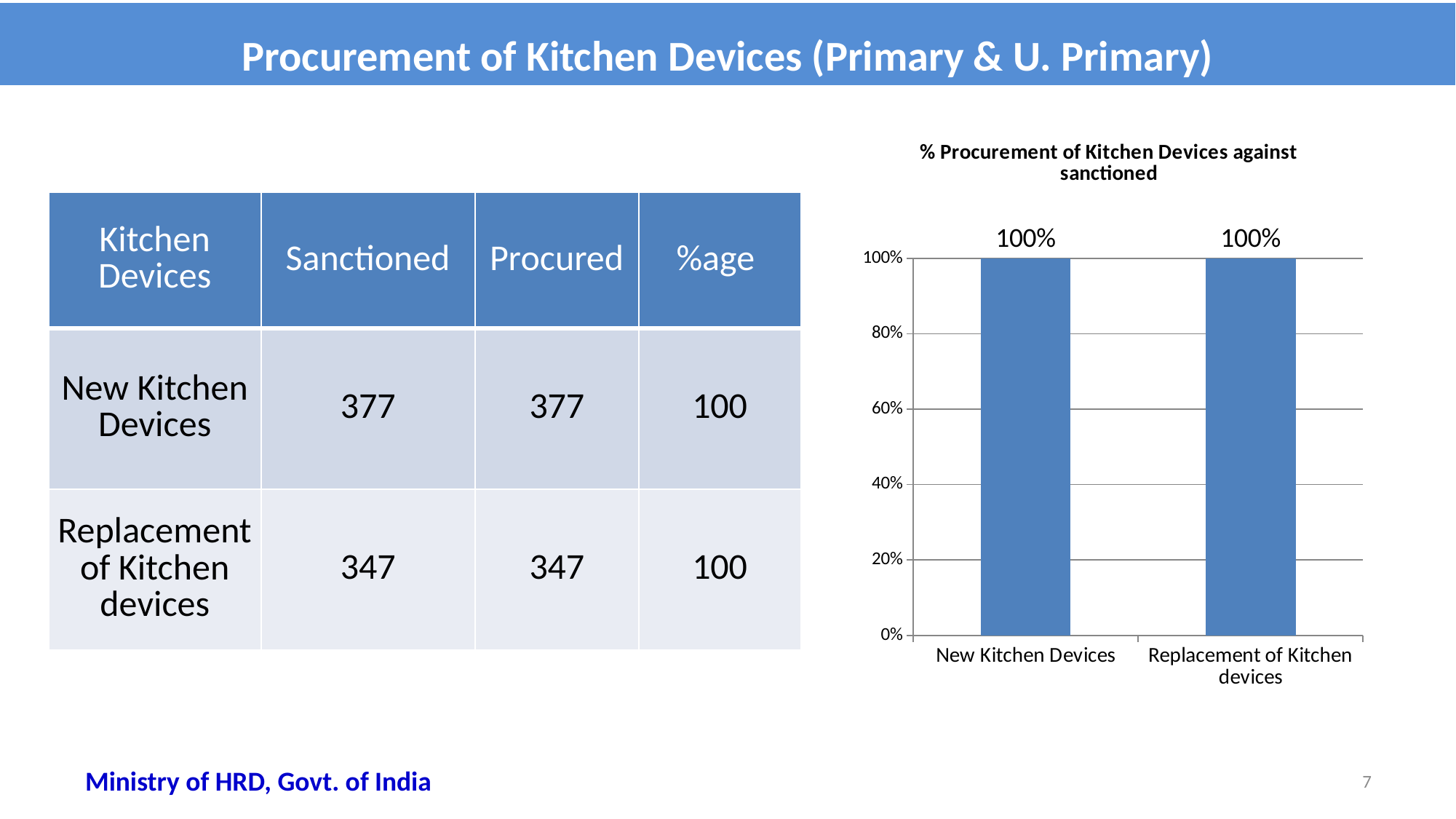
What is the value for Replacement of Kitchen devices in the chart? 100% What is the value for New Kitchen Devices in the chart? 100% Do the values rise, fall or stay the same from New Kitchen Devices to Replacement of Kitchen devices? stay the same What is the highest value shown on the chart's y axis? 100% What is the title of the chart? % Procurement of Kitchen Devices against sanctioned What is the difference between the values for New Kitchen Devices and Replacement of Kitchen devices? 0% Is the value for Replacement of Kitchen devices greater or less than 60%? greater Is the value for New Kitchen Devices greater or less than 80%? greater How many categories are shown on the x axis of the chart? 2 What kind of chart is shown on the slide? bar chart